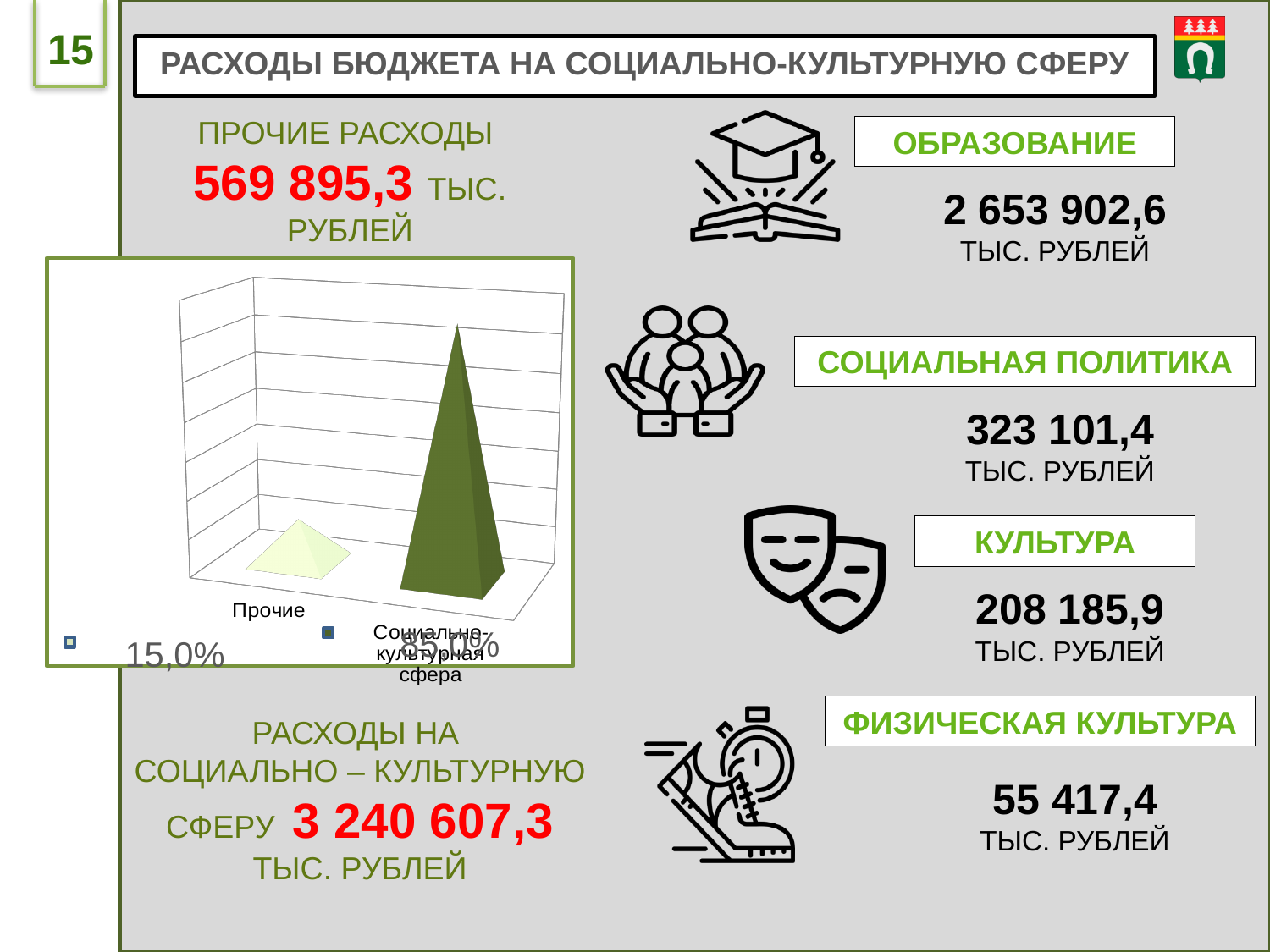
Which category has the highest value in the chart? Социально-культурная сфера Which is larger in the chart: Прочие or Социально-культурная сфера? Социально-культурная сфера Which category in the chart is drawn in dark green? Социально-культурная сфера What kind of chart is shown on the slide? bar chart How many categories are plotted in the chart? 2 What is the value shown for Социально-культурная сфера in the chart? 85,0% Which category in the chart is drawn in pale light green? Прочие What is the difference between the values for Социально-культурная сфера and Прочие in the chart? 70,0% What is the value shown for Прочие in the chart? 15,0% Which category has the lowest value in the chart? Прочие